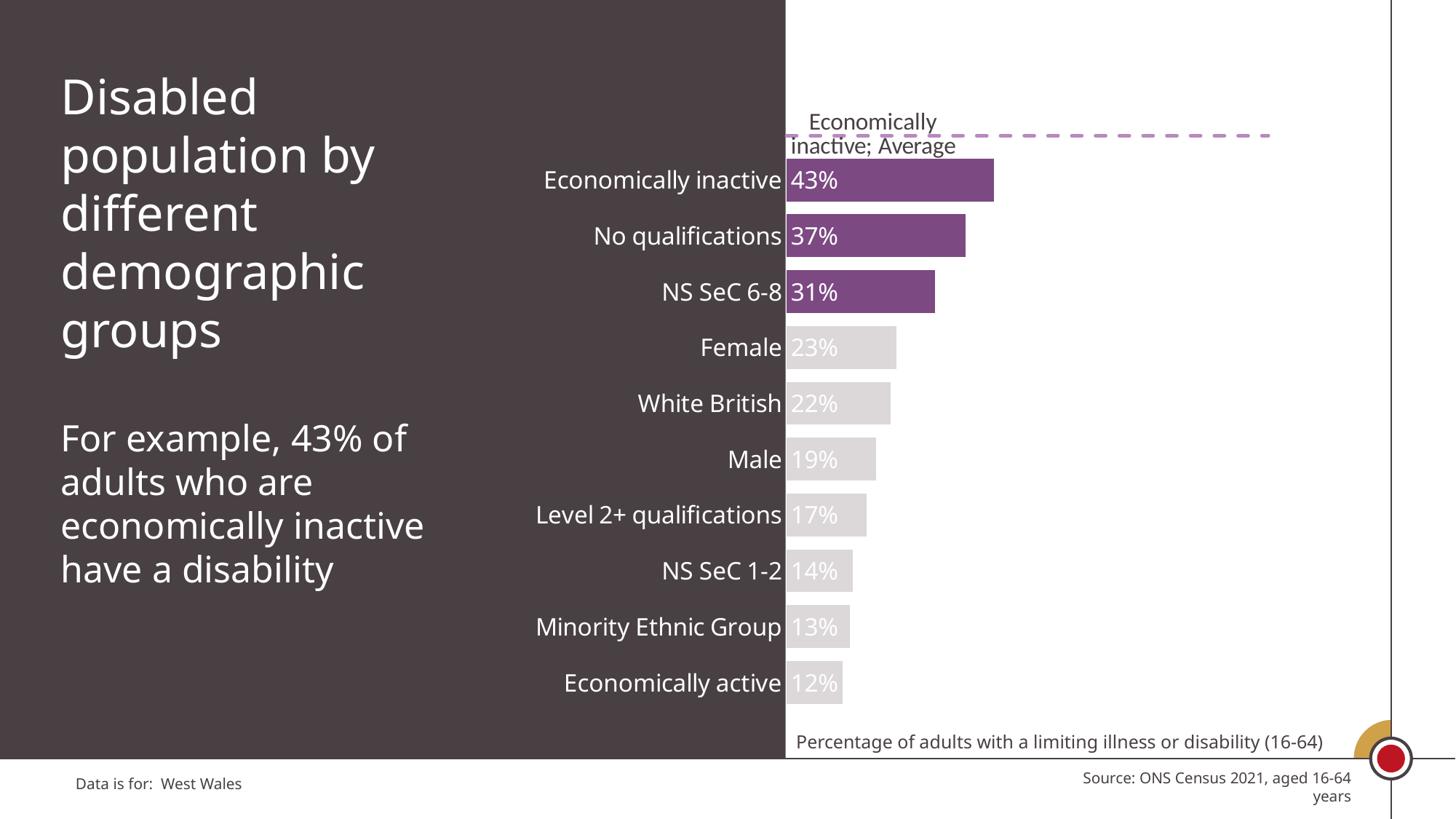
Which three bars are highlighted in purple? Economically inactive, No qualifications, NS SeC 6-8 What is the label of the dashed line at the top of the chart? Economically inactive; Average Which demographic group has the highest percentage of adults with a limiting illness or disability? Economically inactive Which has a higher value, White British or Level 2+ qualifications? White British What is the value shown for the No qualifications group? 37% What is the value shown for Minority Ethnic Group? 13% What percentage of economically inactive adults have a limiting illness or disability? 43% What is the difference between the values for Female and Male? 4% What type of chart is shown on the slide? Bar chart How many demographic groups are shown in the chart? 10 Which demographic group has the lowest percentage of adults with a limiting illness or disability? Economically active What is the difference between the values for NS SeC 6-8 and NS SeC 1-2? 17%